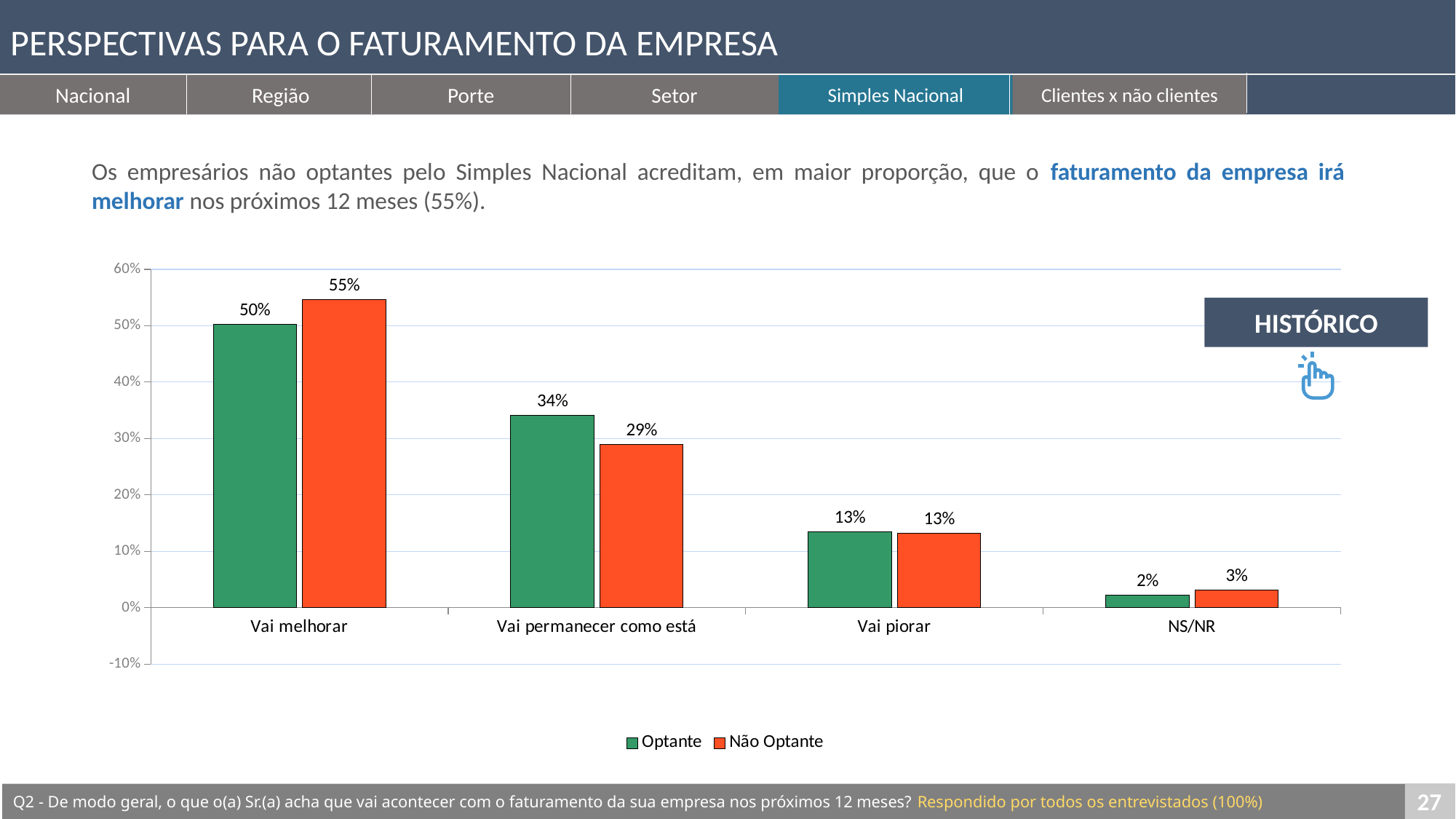
Which colour represents the Não Optante series? Orange Is the value for Optante in 'Vai permanecer como está' greater or less than 30%? greater What is the difference between Não Optante and Optante in the 'Vai melhorar' category? 5% In the 'Vai permanecer como está' category, which series has the larger value, Optante or Não Optante? Optante What is the value for Não Optante in the 'NS/NR' category? 3% Which category has the highest value for Não Optante? Vai melhorar How many categories are shown on the x axis? 4 What is the value for Não Optante in the 'Vai permanecer como está' category? 29% How many series does the legend list? 2 Which category has the lowest value for Optante? NS/NR What is the value for Optante in the 'Vai melhorar' category? 50% What kind of chart is shown on the slide? Bar chart